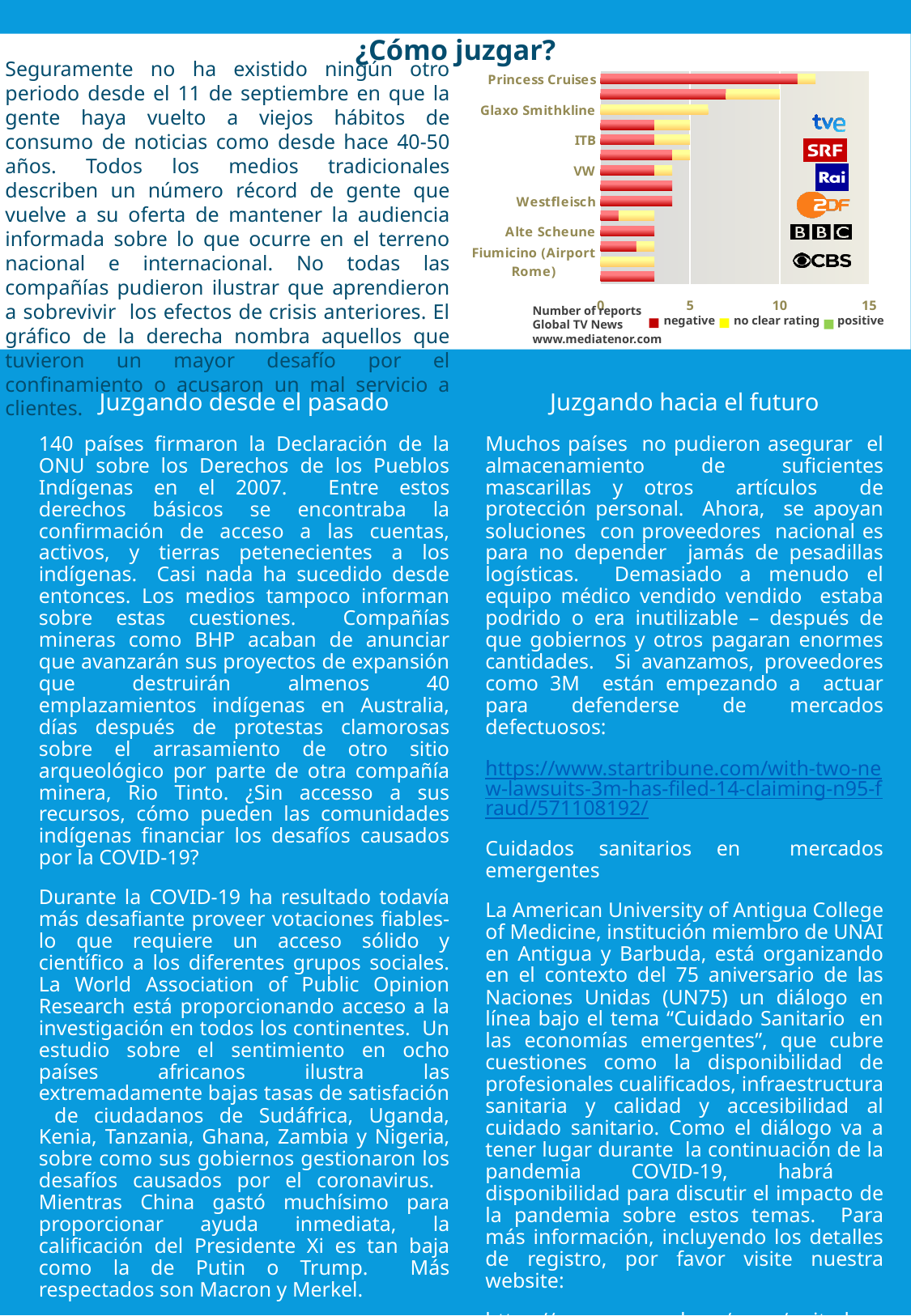
How many series does the chart legend list? 3 Which has more reports in total, Glaxo Smithkline or VW? Glaxo Smithkline Which of the labelled categories has the longest bar in the chart? Princess Cruises Is the total number of reports for Fiumicino (Airport Rome) greater or less than 5? less What kind of chart is shown on the slide? bar chart Which colour represents 'negative' in the chart legend? red Is the total number of reports for Alte Scheune greater or less than 5? less Is the total number of reports for Glaxo Smithkline greater or less than 5? greater Which has more reports in total, Princess Cruises or Glaxo Smithkline? Princess Cruises